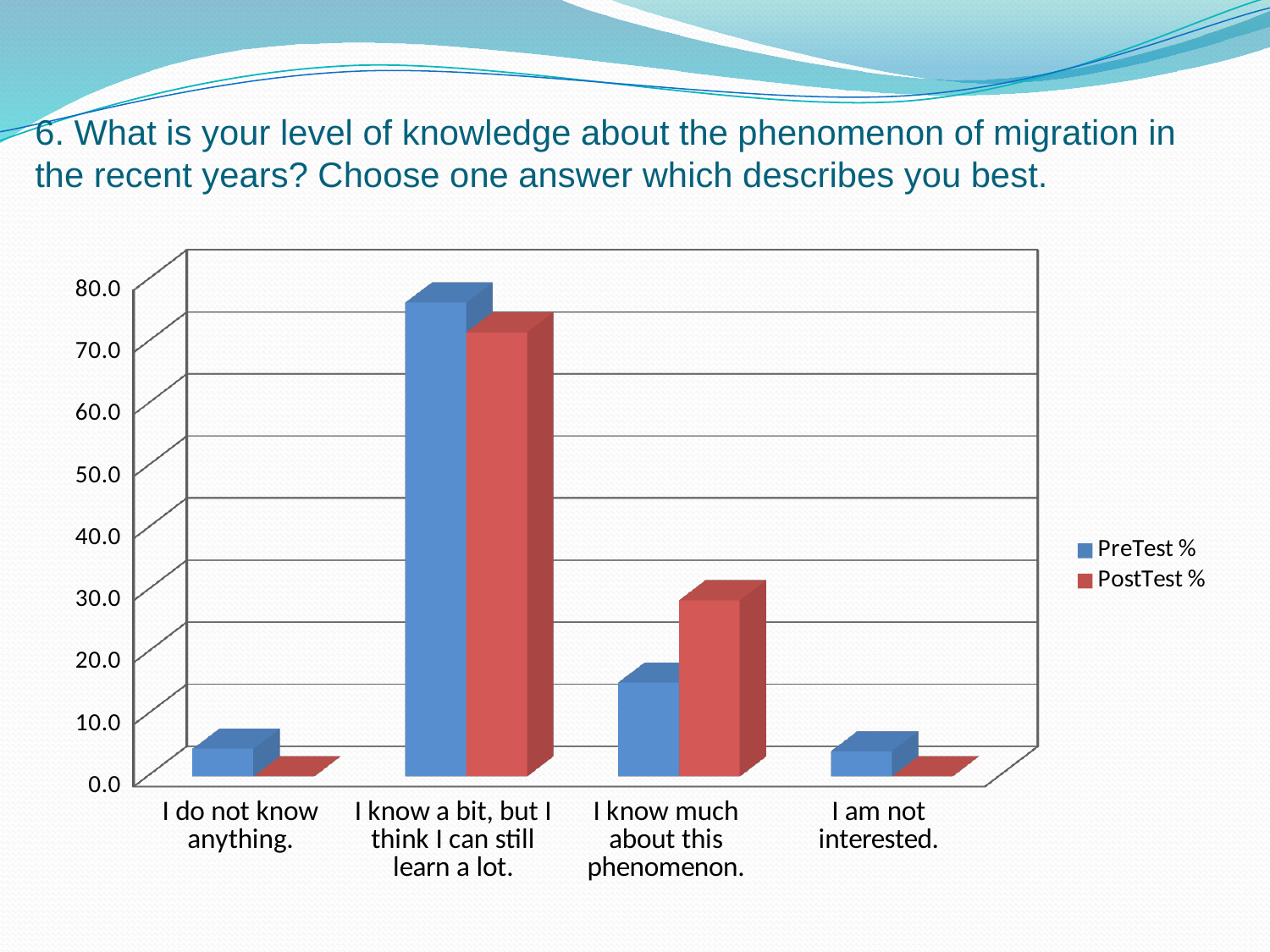
How many answer categories are shown on the x axis? 4 Is the PreTest % value for 'I know much about this phenomenon.' greater or less than 20.0? less Which category has the highest PostTest % value? I know a bit, but I think I can still learn a lot. What kind of chart is shown on the slide? bar chart For 'I know much about this phenomenon.', which is larger: PreTest % or PostTest %? PostTest % Is the PreTest % value for 'I know a bit, but I think I can still learn a lot.' greater or less than 70.0? greater What are the two series names listed in the legend? PreTest % and PostTest % Is the PreTest % value for 'I do not know anything.' greater or less than 10.0? less Which category has the highest PreTest % value? I know a bit, but I think I can still learn a lot. How many series does the legend list? 2 For 'I know a bit, but I think I can still learn a lot.', which is larger: PreTest % or PostTest %? PreTest %